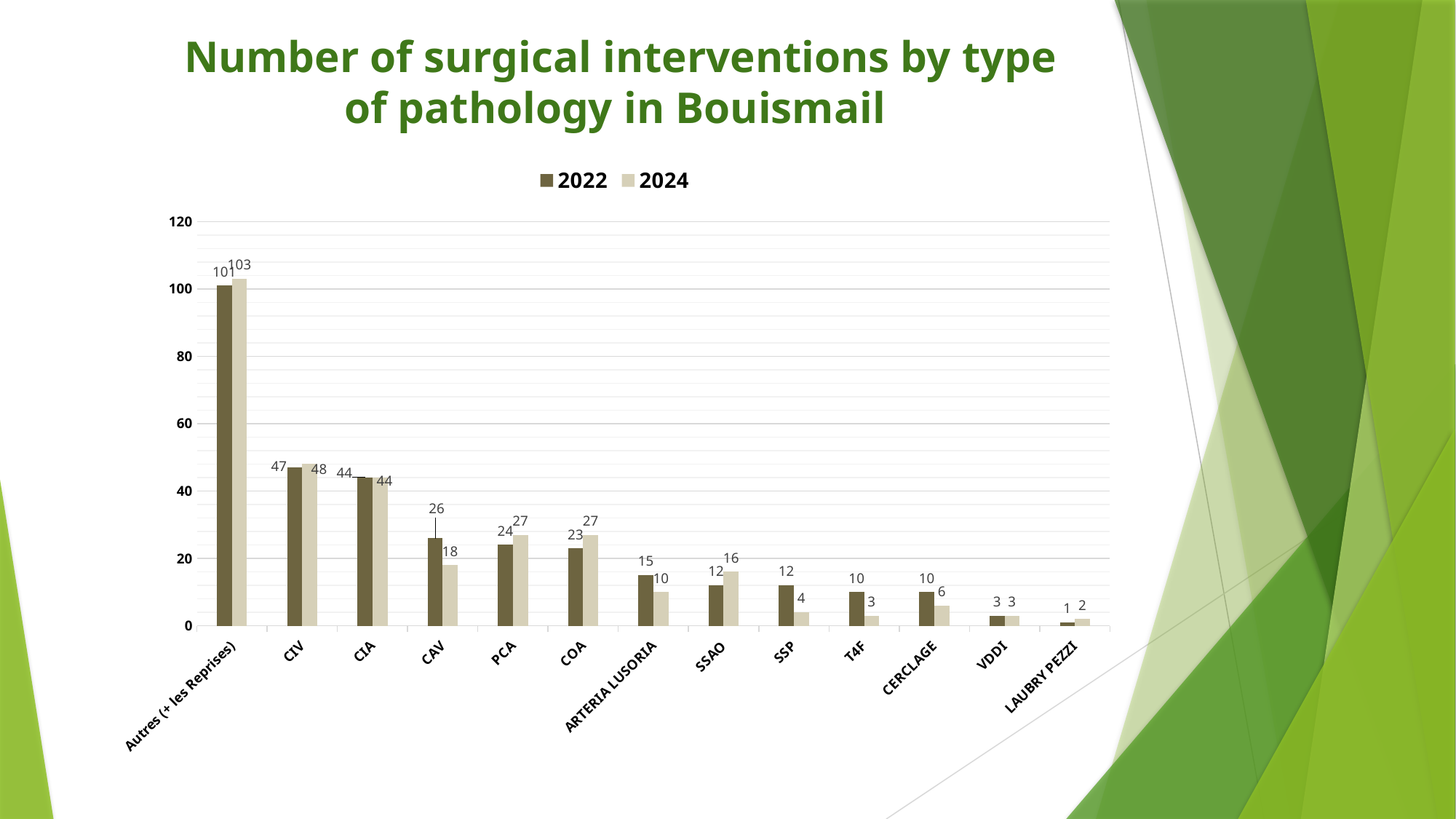
Which category has the lowest 2022 value? LAUBRY PEZZI Which is larger for CAV, the 2022 value or the 2024 value? 2022 What is the title of the chart? Number of surgical interventions by type of pathology in Bouismail How many pathology categories are shown on the x axis? 13 Which category has the highest 2024 value? Autres (+ les Reprises) What kind of chart is shown on the slide? bar chart What is the difference between the 2022 and 2024 values for SSP? 8 What is the 2022 value for CIV? 47 What is the 2024 value for CAV? 18 Is the 2022 value for Autres (+ les Reprises) greater or less than 100? greater How many series does the legend list? 2 What is the 2024 value for SSAO? 16